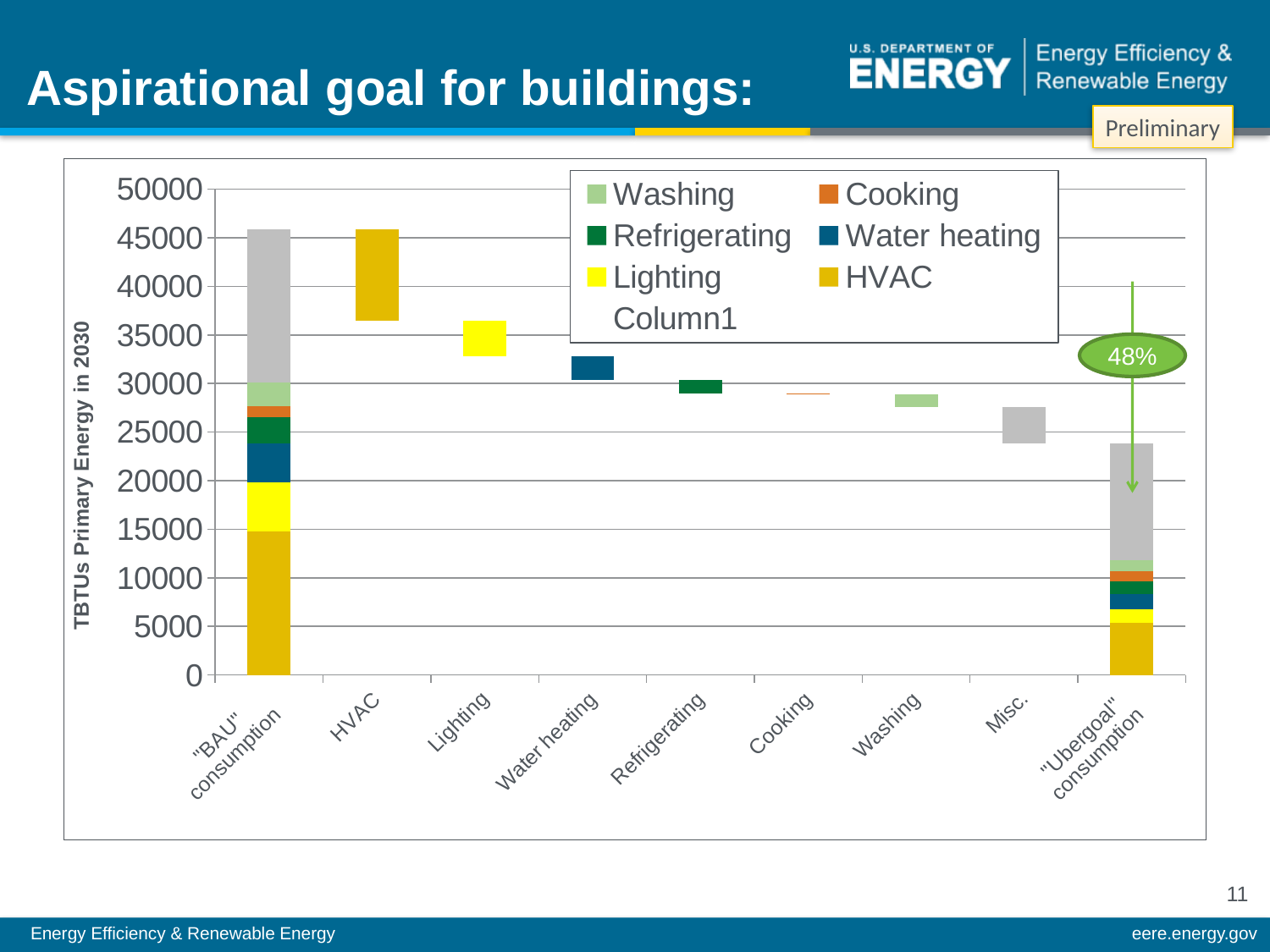
How many entries does the chart's legend list? 7 Is the top of the HVAC bar greater or less than 40000? greater What kind of chart is shown on the slide? bar chart What percentage is shown in the green oval next to the "Ubergoal" consumption bar? 48% Which category has the tallest bar in the chart? "BAU" consumption Is the top of the Misc. bar greater or less than 30000? less Moving from HVAC to Misc. along the x axis, do the floating bars step lower or higher? lower What is the label on the chart's y axis? TBTUs Primary Energy in 2030 Which bar is taller, "BAU" consumption or "Ubergoal" consumption? "BAU" consumption Is the total height of the "Ubergoal" consumption bar greater or less than 30000? less How many categories are shown along the x axis of the chart? 9